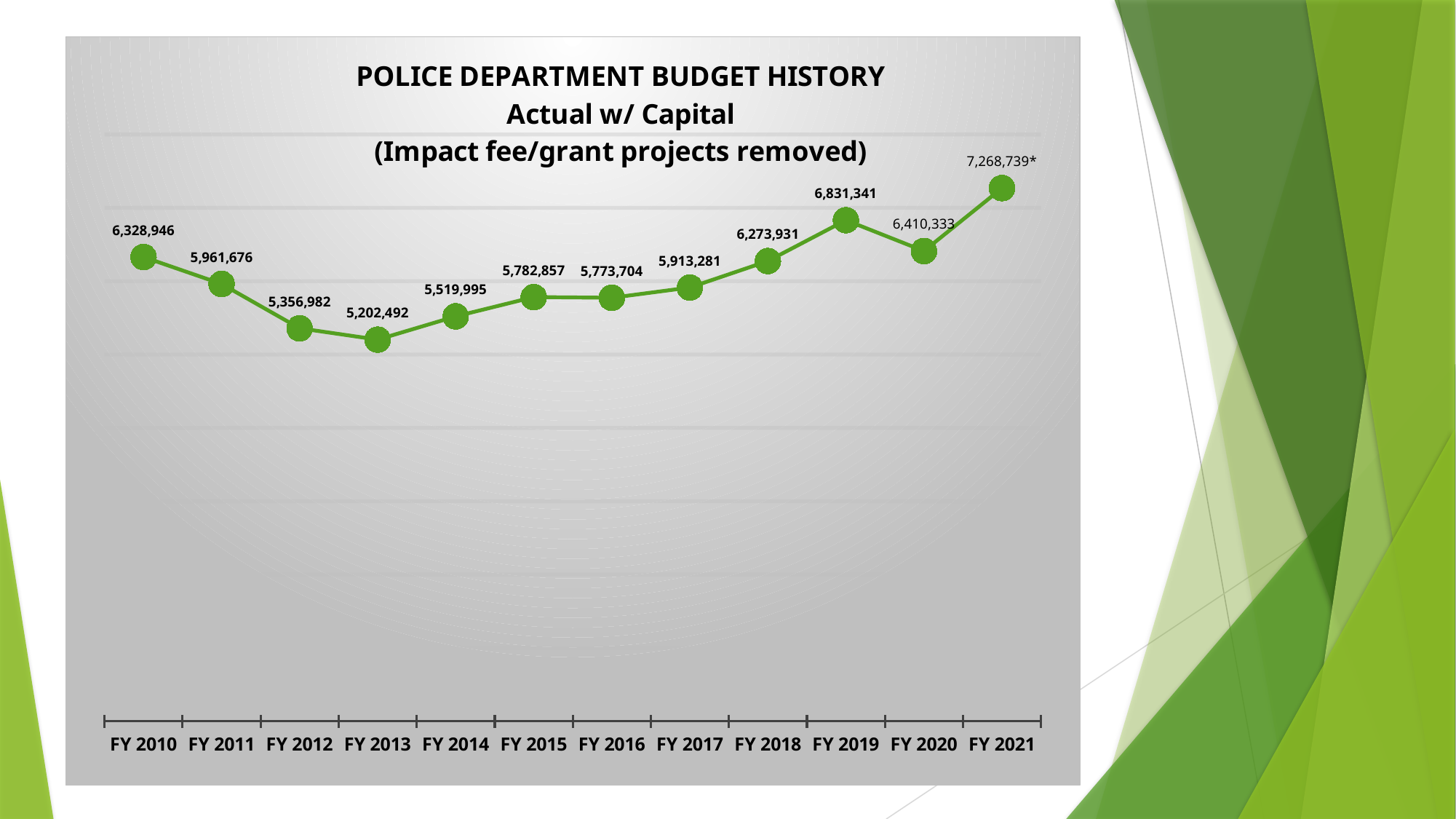
How many fiscal years are plotted on the chart? 12 What kind of chart is shown on the slide? Line chart Do the values rise or fall from FY 2010 to FY 2013? Fall What is the value for FY 2021? 7,268,739* What is the first line of the chart's title? POLICE DEPARTMENT BUDGET HISTORY Which fiscal year has the lowest value? FY 2013 What is the value for FY 2019? 6,831,341 What is the value for FY 2013? 5,202,492 What is the difference between the FY 2010 value and the FY 2013 value? 1,126,454 What is the difference between the FY 2021 value and the FY 2020 value? 858,406 Which fiscal year has the highest value? FY 2021 Which is larger, the value for FY 2010 or the value for FY 2018? FY 2010